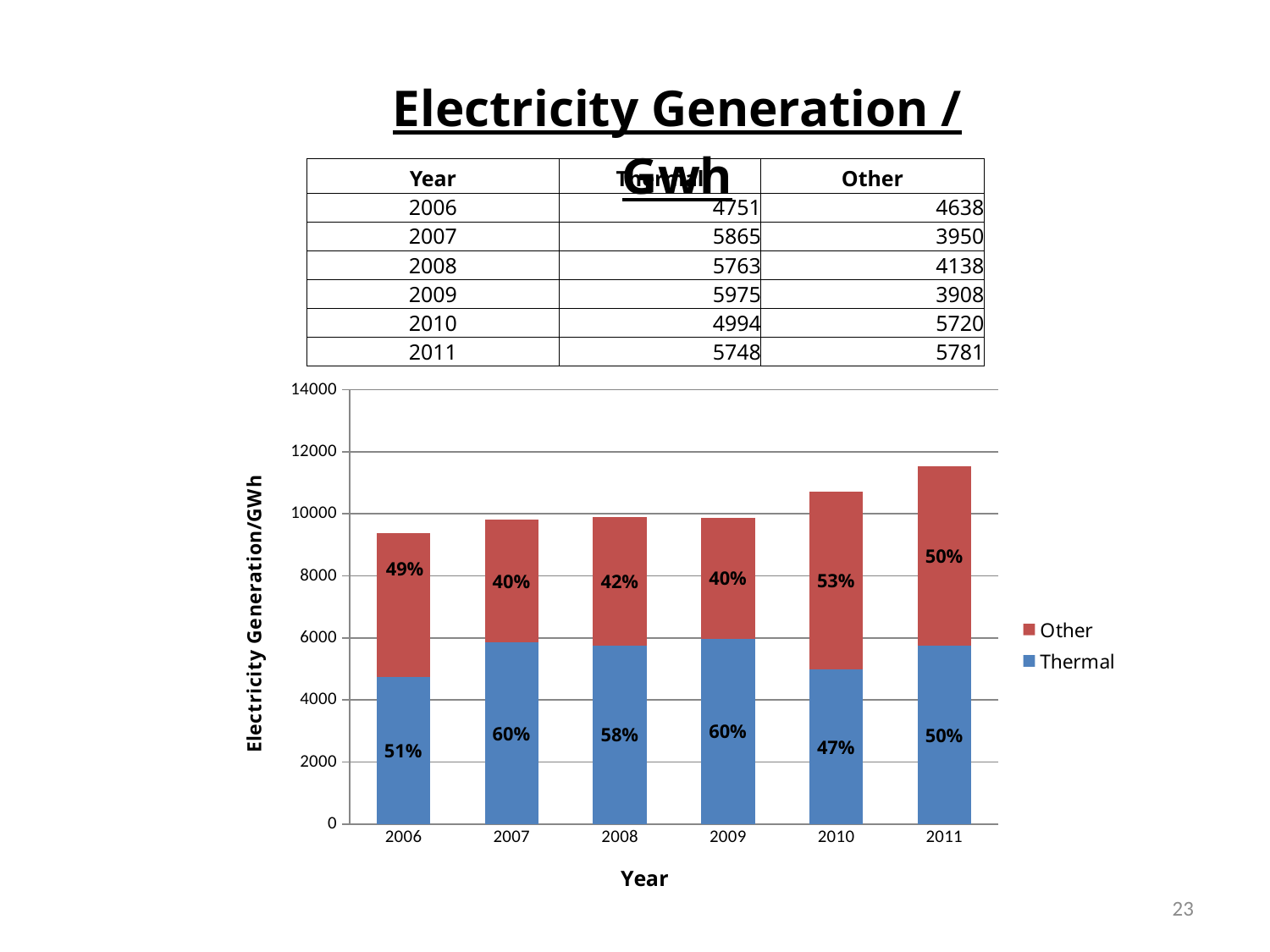
Which year has the shortest stacked bar in the chart? 2006 What percentage label is shown on the Thermal segment for 2011? 50% Which colour represents the Other series in the chart? red How many years are shown on the x axis of the chart? 6 What percentage label is shown on the Thermal segment for 2007? 60% Which year has the tallest stacked bar in the chart? 2011 What kind of chart is shown on the slide? bar chart Is the total bar height for 2010 greater or less than 10000? greater Which year has the larger Thermal percentage label, 2009 or 2010? 2009 Using the table values, what is the total electricity generation for 2011 (Thermal plus Other)? 11529 How many series does the chart legend list? 2 What percentage label is shown on the Other segment for 2010? 53%